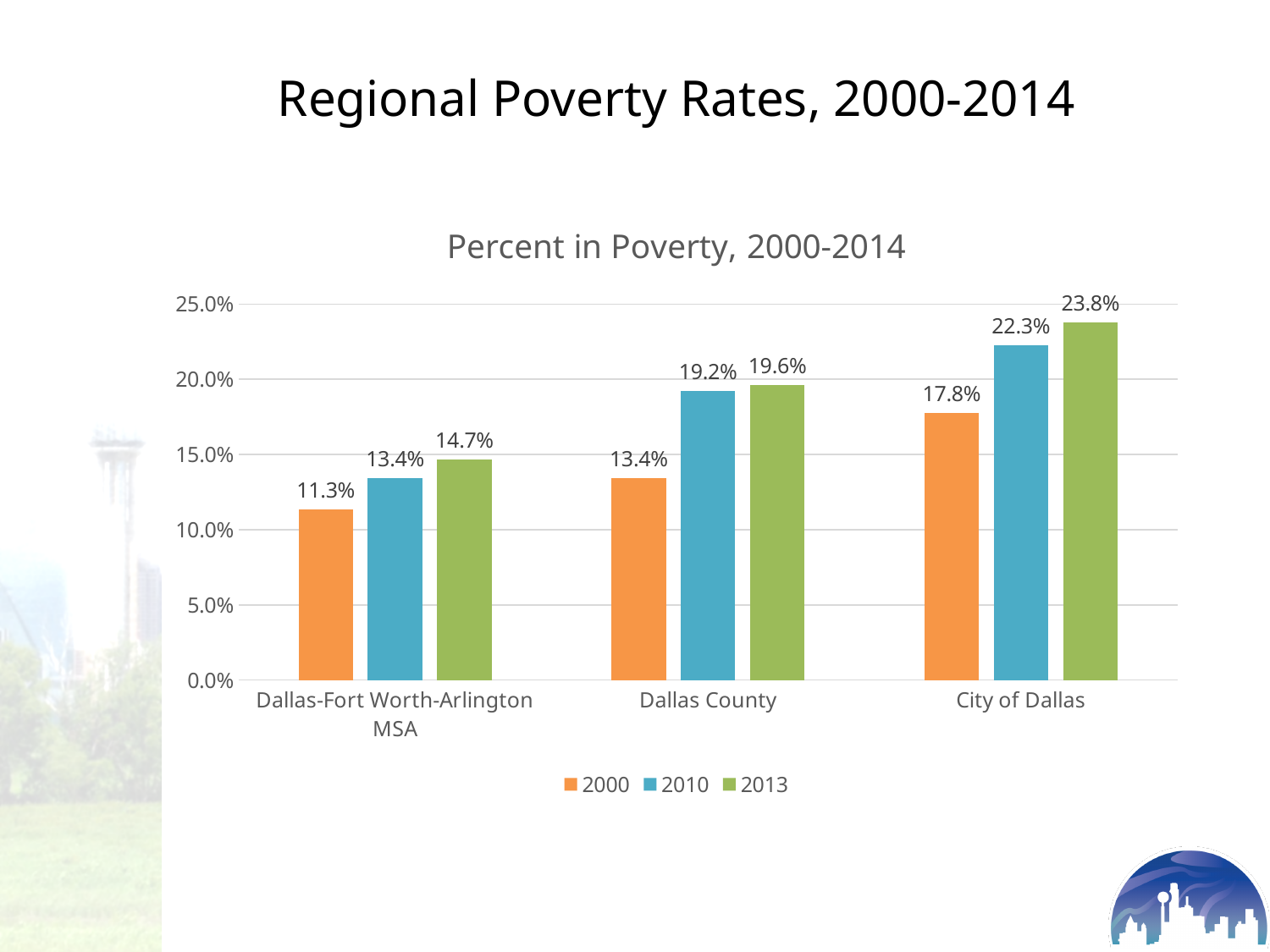
How many series does the chart legend list? 3 Which region had the highest poverty rate in 2013? City of Dallas Which region had the lowest poverty rate in 2000? Dallas-Fort Worth-Arlington MSA What is the difference between the 2010 poverty rates of Dallas County and the Dallas-Fort Worth-Arlington MSA? 5.8 percentage points What was the poverty rate for the Dallas-Fort Worth-Arlington MSA in 2010? 13.4% What type of chart is shown on the slide? Bar chart What was the poverty rate for Dallas County in 2000? 13.4% How many regions are shown on the x axis of the chart? 3 For the Dallas-Fort Worth-Arlington MSA, did the poverty rate rise or fall from 2000 to 2013? Rise By how many percentage points did the City of Dallas poverty rate change from 2000 to 2013? 6.0 percentage points Which was higher in 2010: the poverty rate for Dallas County or for the City of Dallas? City of Dallas What was the poverty rate for the City of Dallas in 2013? 23.8%